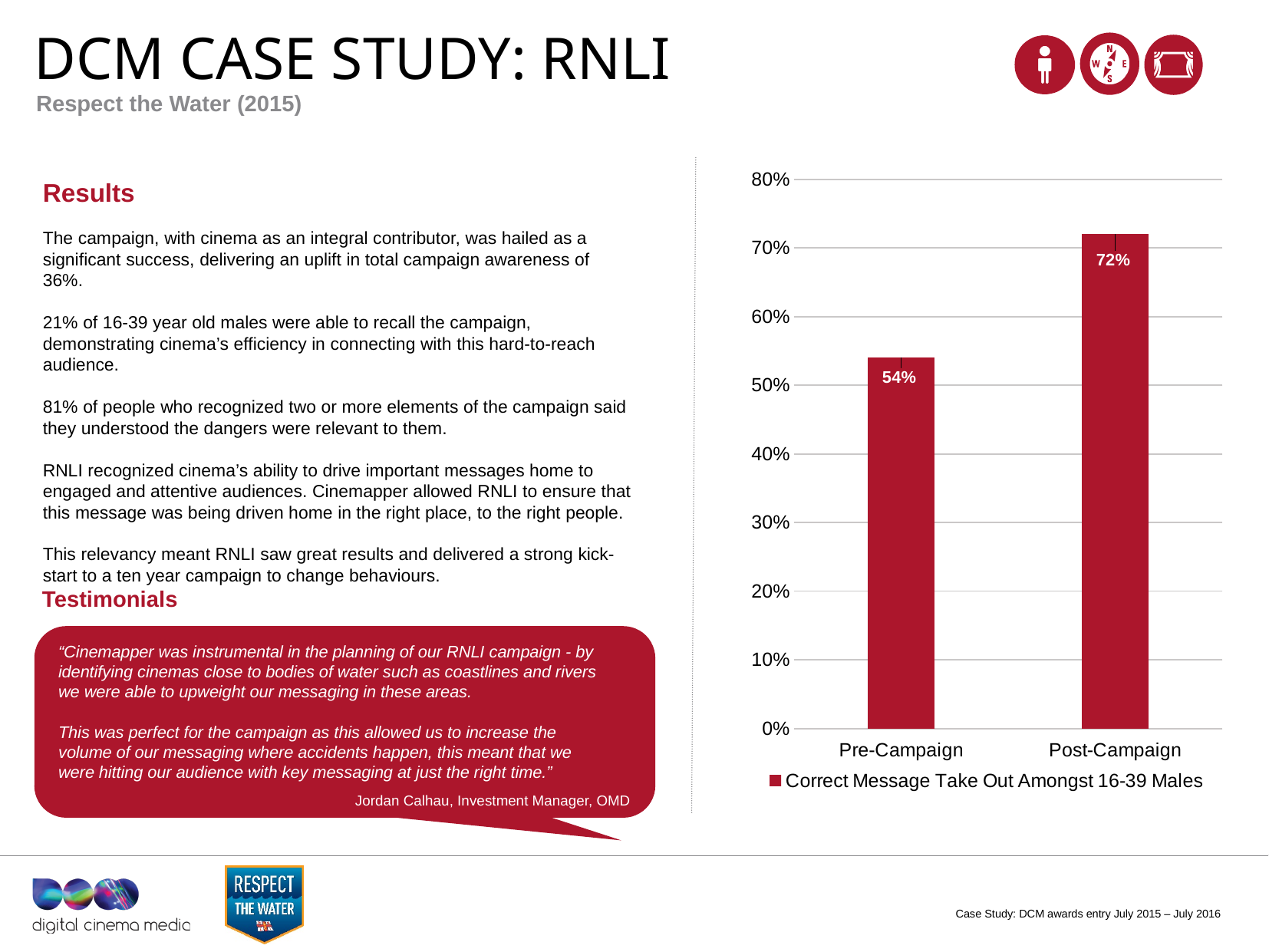
Is the value for Post-Campaign greater or less than 70%? greater What is the difference between the Post-Campaign and Pre-Campaign values? 18% What kind of chart is shown? Bar chart Which category has the highest value? Post-Campaign How many series does the legend list? 1 What is the value for Pre-Campaign? 54% Is the value for Pre-Campaign greater or less than 60%? less Which is larger, the Pre-Campaign value or the Post-Campaign value? Post-Campaign What is the value for Post-Campaign? 72% What is the legend entry for the series shown? Correct Message Take Out Amongst 16-39 Males How many categories are shown on the x axis? 2 Which category has the lowest value? Pre-Campaign